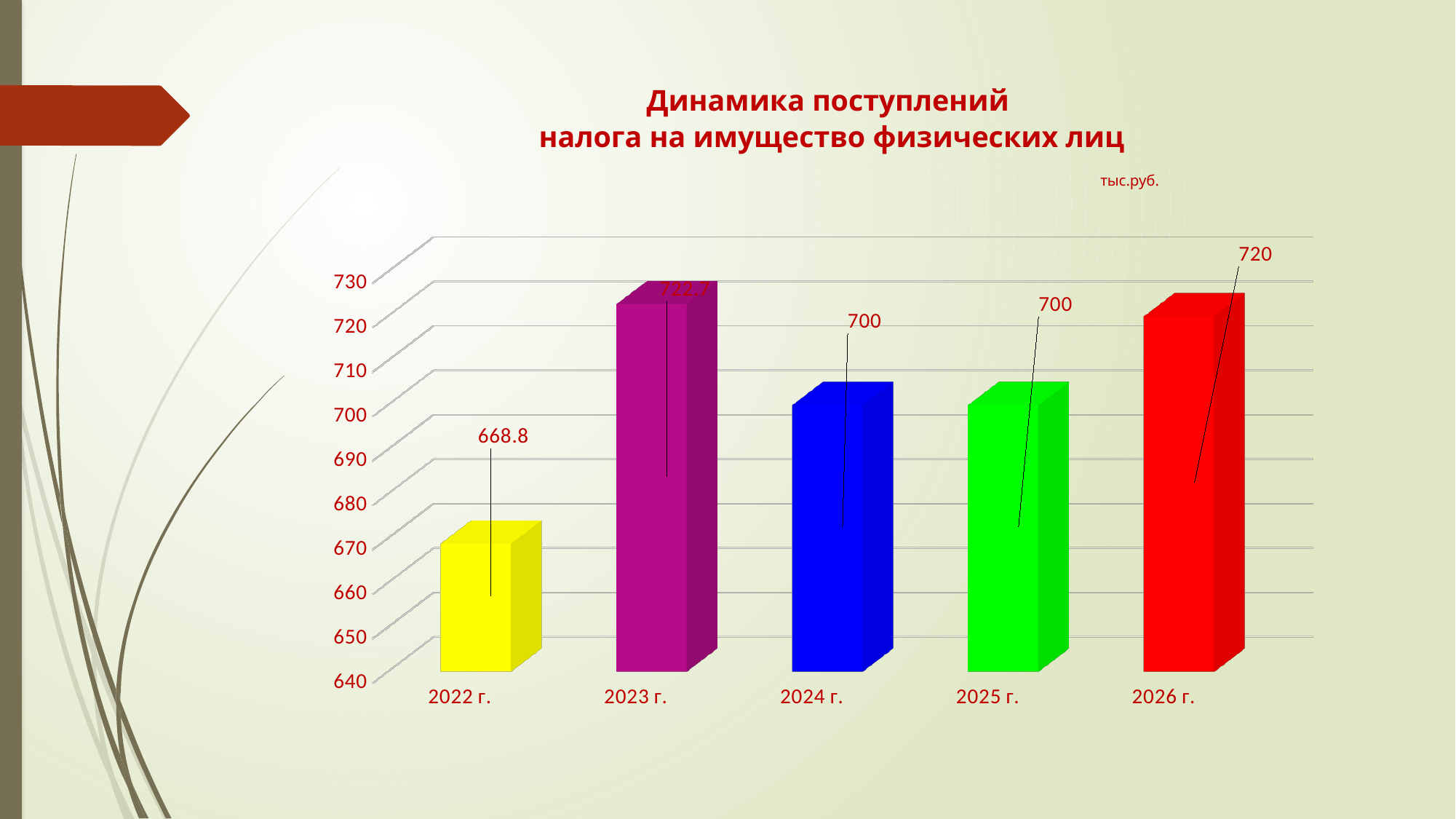
What is the value for 2022 г.? 668.8 What is the difference between the values for 2026 г. and 2024 г.? 20 What unit is indicated for the values on the chart? тыс.руб. What kind of chart is shown on the slide? bar chart Which year has the highest value? 2023 г. What is the difference between the values for 2023 г. and 2022 г.? 53.9 What is the value for 2026 г.? 720 Is the value for 2022 г. greater or less than 680? less What is the value for 2023 г.? 722.7 Which year has the lowest value? 2022 г. How many years are shown on the x axis? 5 Which is larger, the value for 2022 г. or the value for 2025 г.? 2025 г.